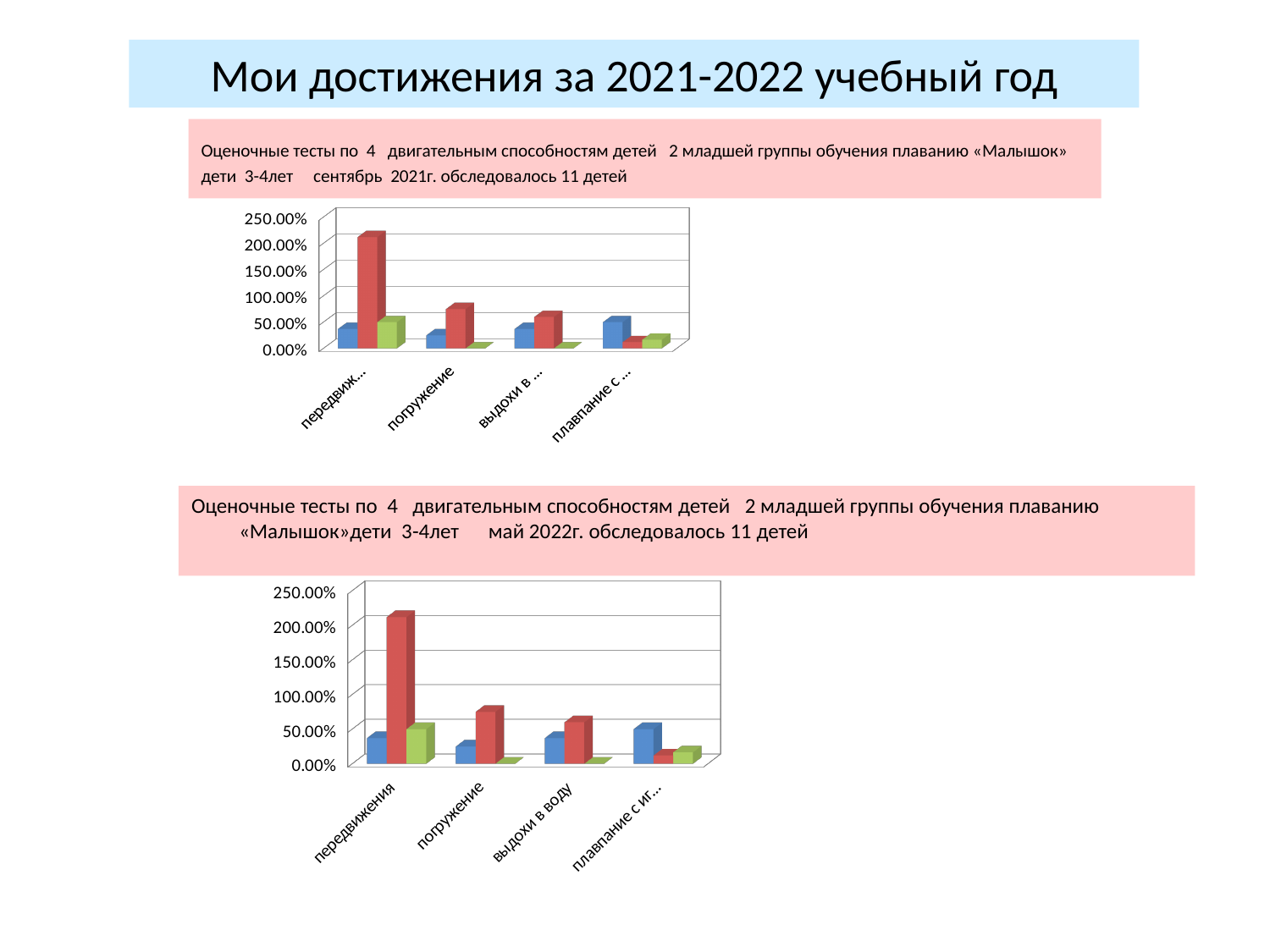
In the bottom chart, which is larger for передвижения: the blue bar or the red bar? the red bar In the top chart, is the red bar for погружение greater or less than 100%? less How many categories are shown on the x axis of the top chart? 4 How many bars are plotted for each category in the bottom chart? 3 What is the highest value shown on the y axis of the top chart? 250.00% What kind of chart is the bottom chart on the slide? bar chart In the bottom chart, is the blue bar for выдохи в воду greater or less than 50%? less In the top chart, is the red bar for погружение greater or less than 50%? greater How many categories are shown on the x axis of the bottom chart? 4 In the bottom chart, which category has the tallest bar? передвижения What kind of chart is the top chart on the slide? bar chart